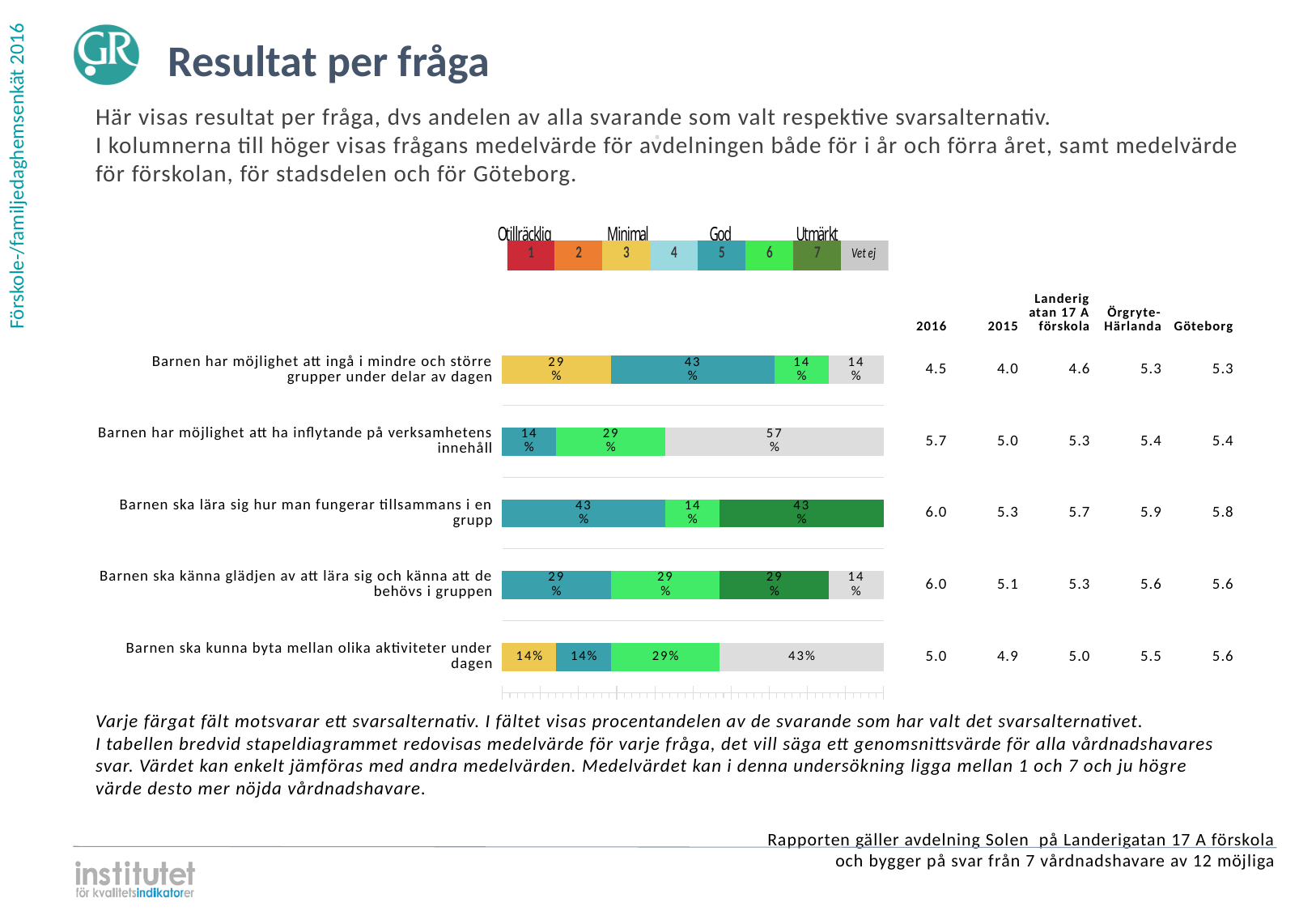
How many questions (bars) are shown in the chart? 5 Which question has the larger 'Vet ej' share: 'Barnen ska kunna byta mellan olika aktiviteter under dagen' or 'Barnen har möjlighet att ha inflytande på verksamhetens innehåll'? Barnen har möjlighet att ha inflytande på verksamhetens innehåll What is the largest segment in the bar for 'Barnen har möjlighet att ingå i mindre och större grupper under delar av dagen'? 43% What percentage of respondents chose answer option 7 for 'Barnen ska lära sig hur man fungerar tillsammans i en grupp'? 43% What is the 2016 mean value for 'Barnen ska lära sig hur man fungerar tillsammans i en grupp'? 6.0 Which answer option does the dark green colour in the legend represent? 7 (Utmärkt) What percentage of respondents chose answer option 3 (yellow) for 'Barnen ska kunna byta mellan olika aktiviteter under dagen'? 14% What percentage of respondents answered 'Vet ej' for 'Barnen har möjlighet att ha inflytande på verksamhetens innehåll'? 57% What kind of chart is used to show the share of respondents choosing each answer option? Stacked bar chart Which question has the lowest 2016 mean value? Barnen har möjlighet att ingå i mindre och större grupper under delar av dagen For 'Barnen ska känna glädjen av att lära sig och känna att de behövs i gruppen', what is the difference between the share choosing option 5 and the share answering 'Vet ej'? 15 percentage points What is the Göteborg mean value for 'Barnen har möjlighet att ingå i mindre och större grupper under delar av dagen'? 5.3